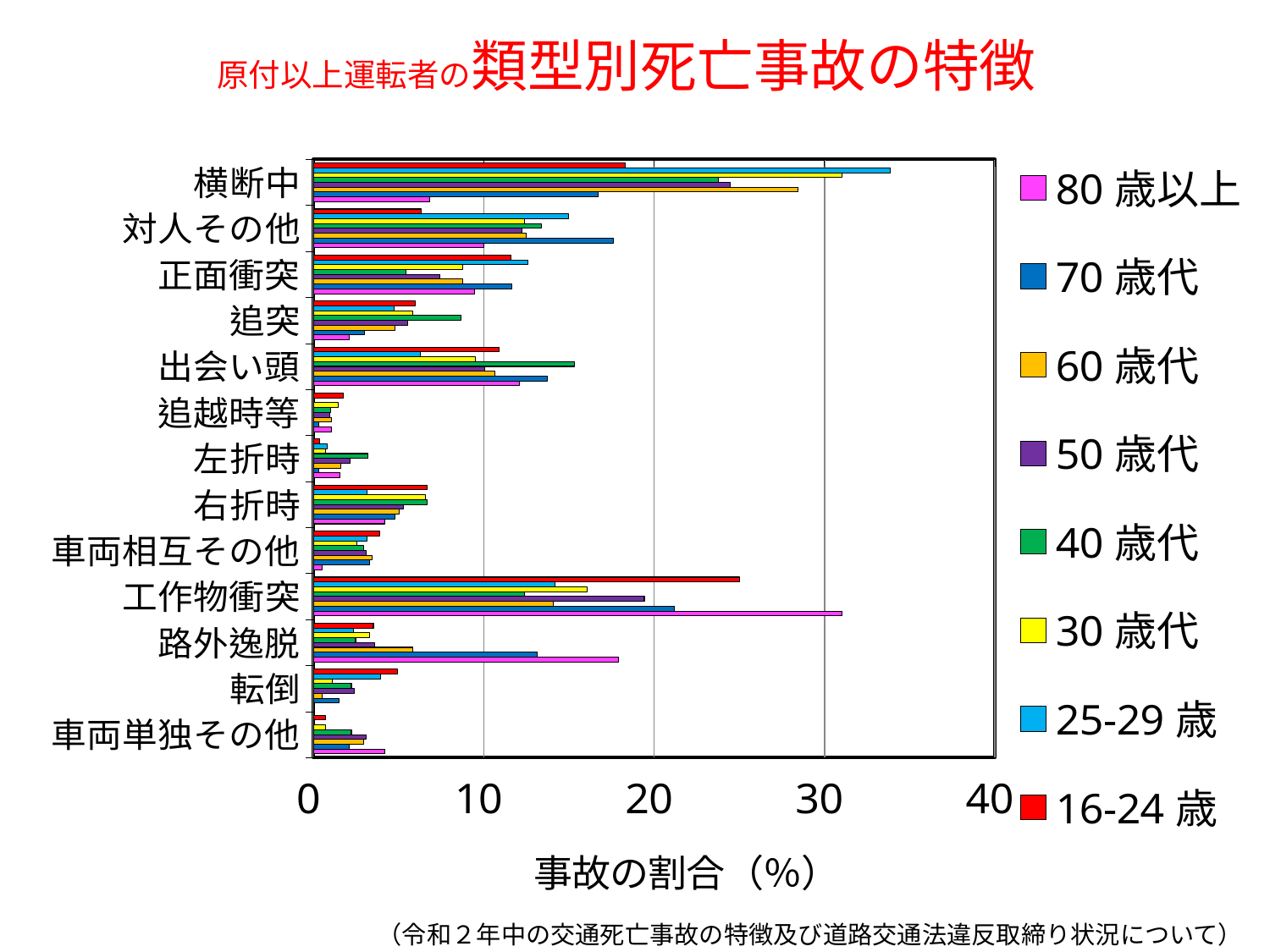
In the 横断中 category, which is larger: the value for 25-29 歳 or the value for 80 歳以上? 25-29 歳 What is the title of the horizontal axis? 事故の割合（%） In the 工作物衝突 category, which is larger: the value for 80 歳以上 or the value for 40 歳代? 80 歳以上 In the 工作物衝突 category, which age group has the highest value? 80 歳以上 How many age-group series does the legend list? 8 Is the value for 16-24 歳 in the 追越時等 category greater or less than 10? less What kind of chart is shown on the slide? bar chart Is the value for 80 歳以上 in the 横断中 category greater or less than 10? less Is the value for 80 歳以上 in the 工作物衝突 category greater or less than 20? greater In the 横断中 category, which age group has the highest value? 25-29 歳 How many accident-type categories are listed on the vertical axis? 13